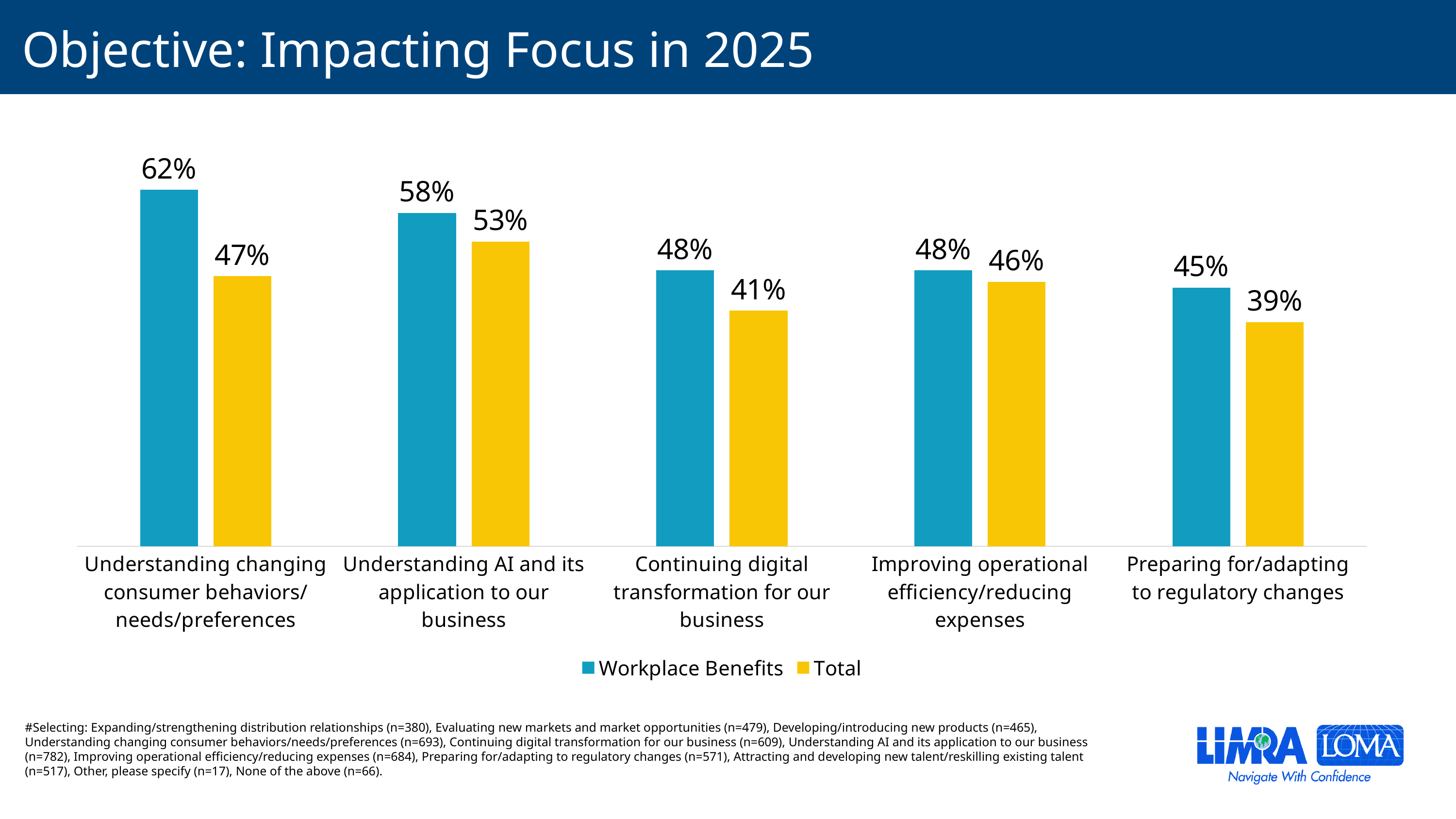
What is the Total value for Understanding AI and its application to our business? 53% What is the Workplace Benefits value for Understanding changing consumer behaviors/needs/preferences? 62% Which is larger for Improving operational efficiency/reducing expenses: the Workplace Benefits value or the Total value? Workplace Benefits How many series does the legend list? 2 What kind of chart is shown on the slide? Bar chart Which category has the highest Workplace Benefits value? Understanding changing consumer behaviors/needs/preferences How many categories are shown on the x axis? 5 Which series is shown in yellow? Total What is the difference between the Workplace Benefits and Total values for Understanding changing consumer behaviors/needs/preferences? 15% Which category has the lowest Total value? Preparing for/adapting to regulatory changes What is the difference between the Workplace Benefits and Total values for Continuing digital transformation for our business? 7% What is the Total value for Preparing for/adapting to regulatory changes? 39%